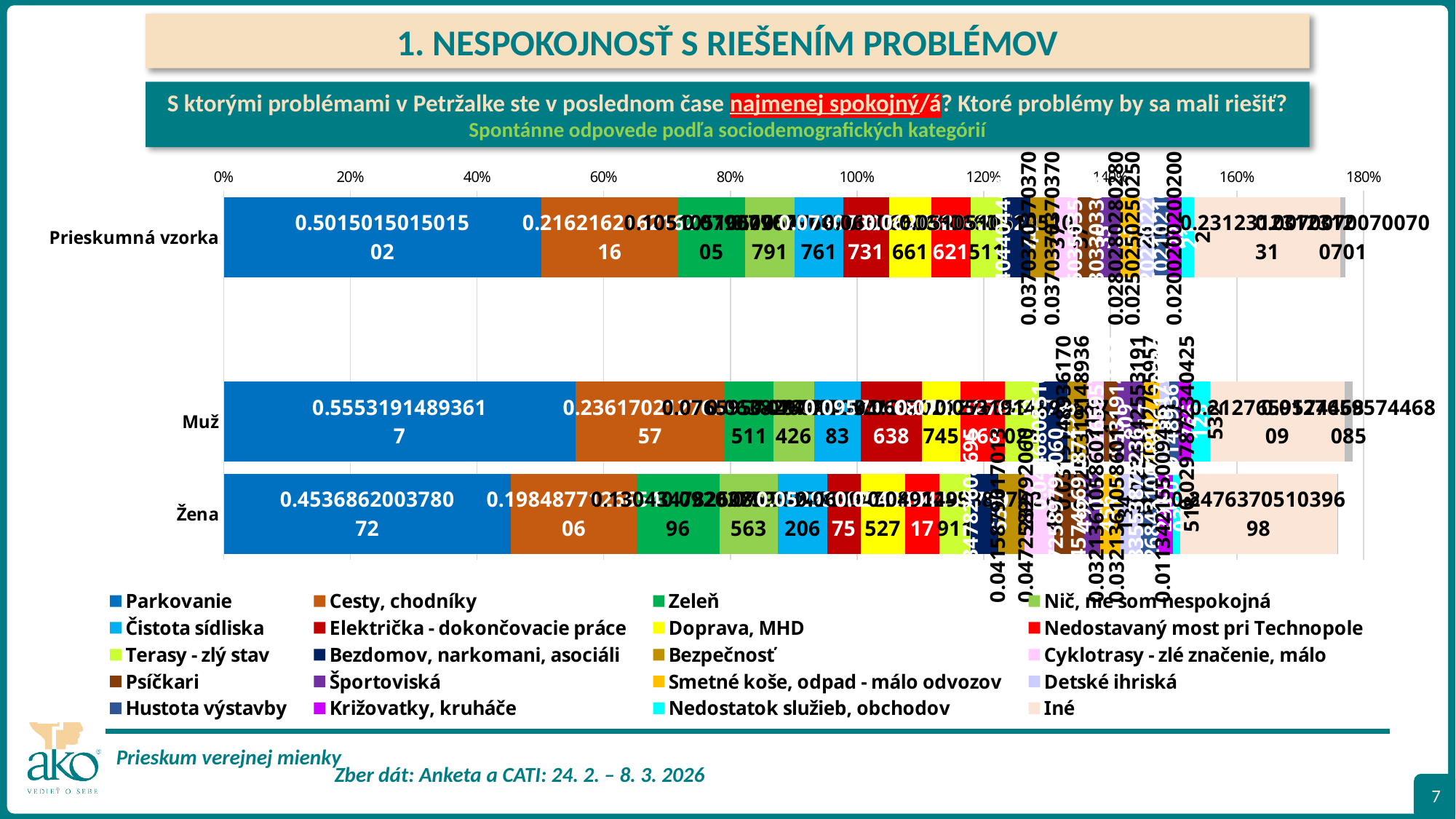
What colour represents Parkovanie in the legend? blue Which is larger, the Parkovanie value for Muž or for Žena? Muž Which category has the lowest value for Parkovanie? Žena What is the value of the Parkovanie segment for Žena? 0.453686200378072 What is the value of the Parkovanie segment for Prieskumná vzorka? 0.501501501501502 How many series does the legend list? 20 Which category has the highest value for Parkovanie? Muž What kind of chart is shown on the slide? stacked bar chart What is the value of the Parkovanie segment for Muž? 0.55531914893617 How many categories (rows) does the chart show? 3 Is the Parkovanie segment for Žena greater or less than 60% on the axis? less What is the difference between the Parkovanie values for Muž and Žena? 0.101632948558098